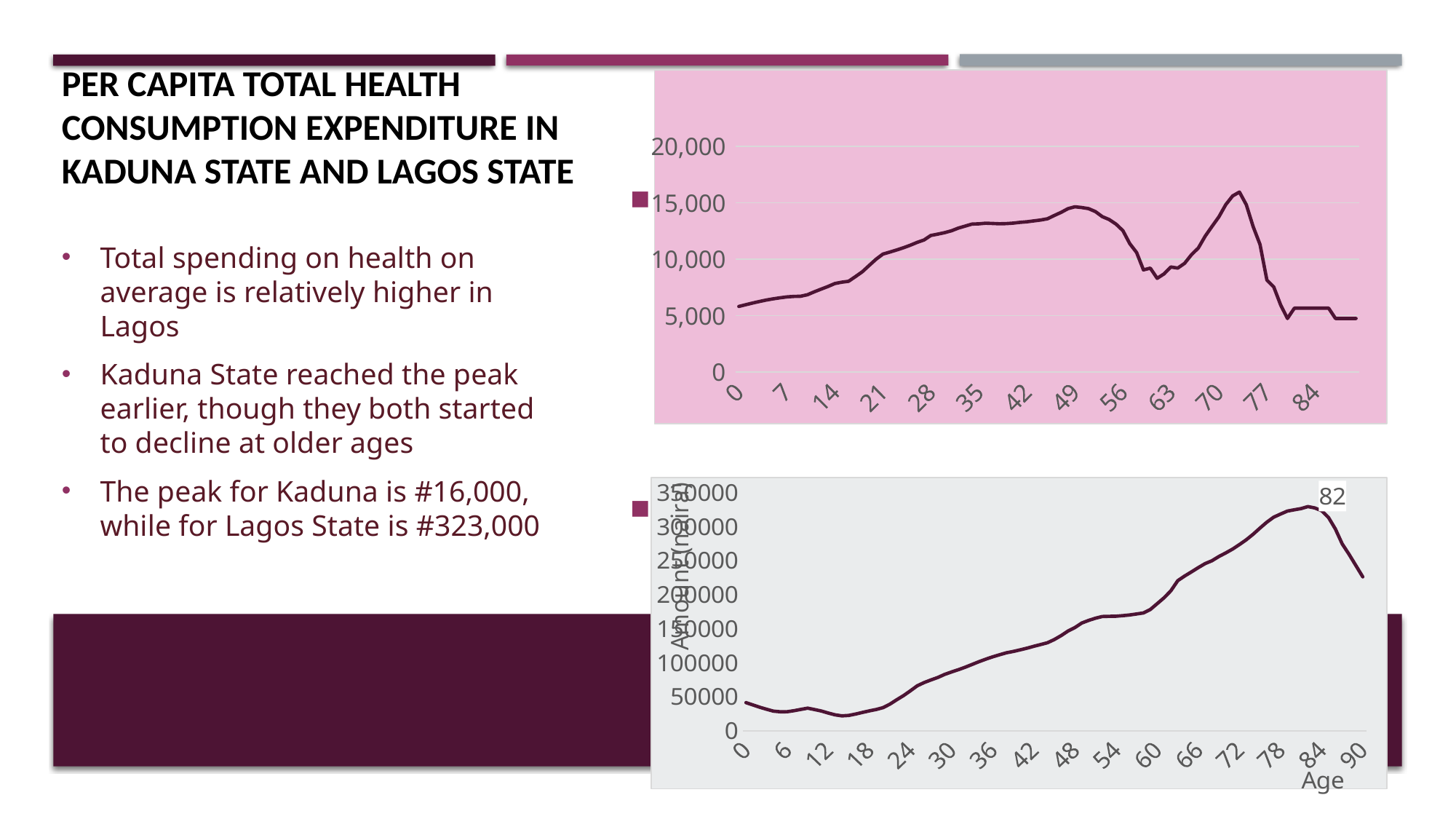
In the bottom chart, is the value at age 90 greater or less than 150000? greater In the top chart, is the value at age 49 greater or less than 10,000? greater What kind of chart is the bottom chart on the slide? line chart In the top chart, which is larger: the value at age 49 or the value at age 84? age 49 What kind of chart is the top chart on the slide? line chart In the bottom chart, is the value at age 78 greater or less than 250000? greater In the top chart, do the values rise or fall between age 77 and age 84? fall What is the x-axis title of the bottom chart? Age In the bottom chart, do the values rise or fall between age 24 and age 78? rise What is the highest tick value shown on the y axis of the top chart? 20,000